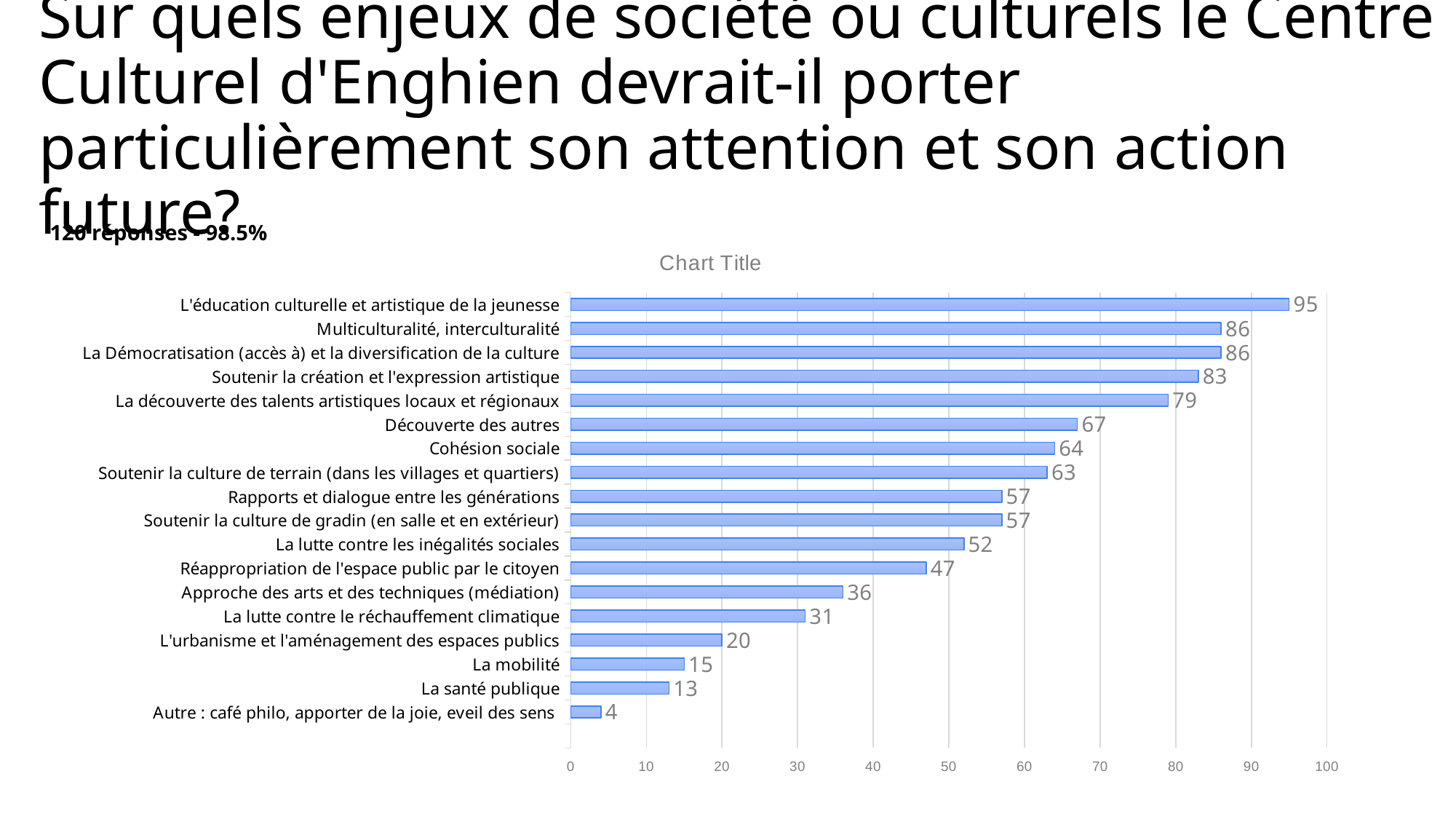
Is the value for "Réappropriation de l'espace public par le citoyen" greater or less than 50? less How many categories are plotted in the chart? 18 Which is larger: the value for "Découverte des autres" or the value for "La lutte contre les inégalités sociales"? Découverte des autres What value is shown for "La lutte contre le réchauffement climatique"? 31 What value is shown for "Cohésion sociale"? 64 What value is shown for "Soutenir la création et l'expression artistique"? 83 What kind of chart is shown on the slide? bar chart Which category has the highest value? L'éducation culturelle et artistique de la jeunesse What is the difference between the values for "Multiculturalité, interculturalité" and "La découverte des talents artistiques locaux et régionaux"? 7 What is the title printed above the chart? Chart Title What is the difference between the values for "L'éducation culturelle et artistique de la jeunesse" and "La santé publique"? 82 Which category has the lowest value? Autre : café philo, apporter de la joie, eveil des sens